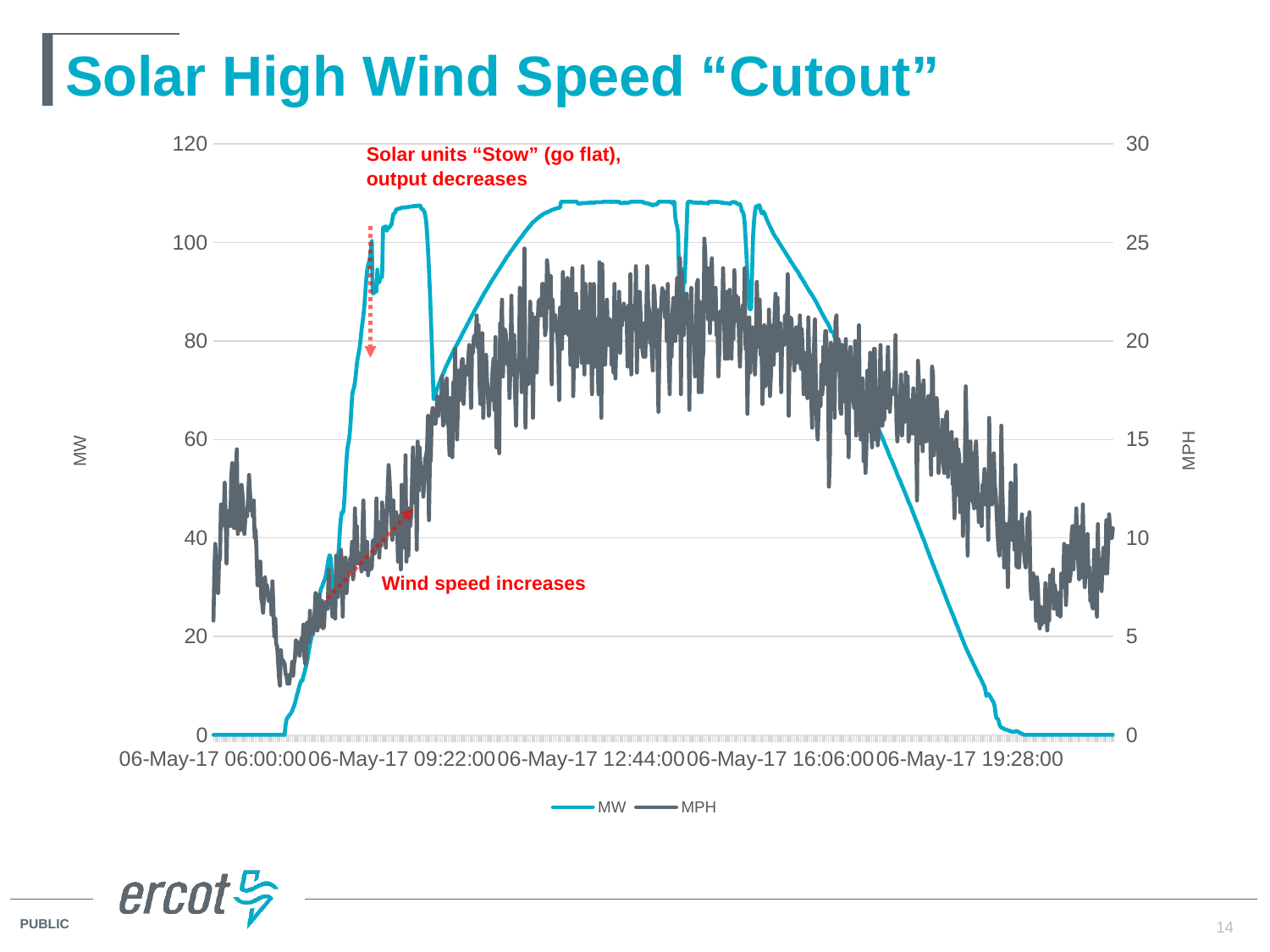
Is the MPH value at 06-May-17 12:44:00 greater or less than 15? greater Does the MW series rise or fall between 06-May-17 06:00:00 and 06-May-17 12:44:00? rise Is the MW value at 06-May-17 12:44:00 greater or less than 100? greater What are the two series named in the legend? MW and MPH Is the MW value larger at 06-May-17 12:44:00 or at 06-May-17 19:28:00? 06-May-17 12:44:00 What kind of chart is shown on the slide? line chart How many series does the legend list? 2 What is the label of the right-hand vertical axis? MPH Is the MW value at 06-May-17 16:06:00 greater or less than 60? greater Does the MW series rise or fall between 06-May-17 16:06:00 and 06-May-17 19:28:00? fall How many time labels are shown along the x axis? 5